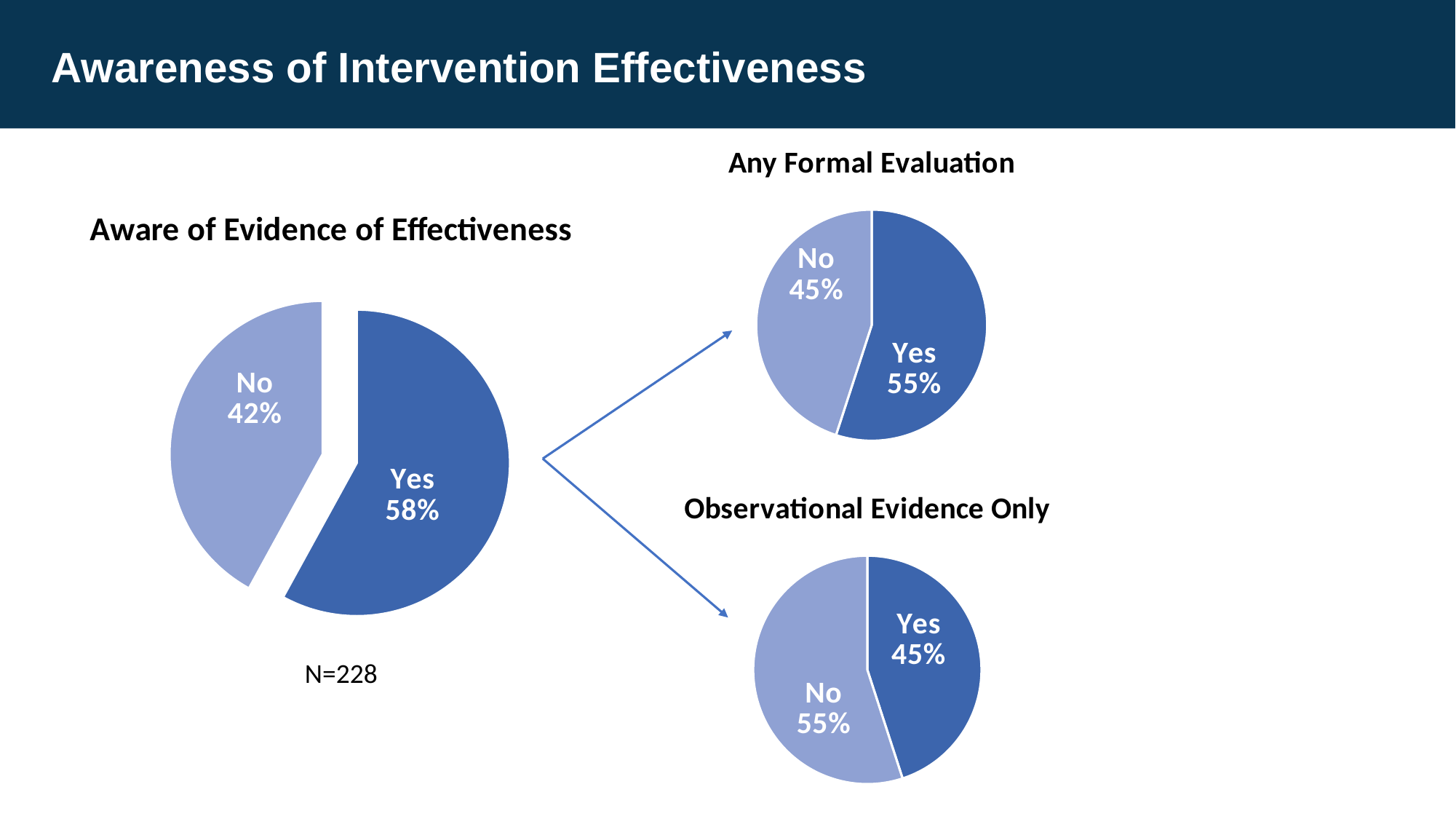
In the 'Aware of Evidence of Effectiveness' chart, what percentage answered No? 42% In the 'Aware of Evidence of Effectiveness' chart, what percentage answered Yes? 58% How many slices does the 'Observational Evidence Only' chart have? 2 In the 'Aware of Evidence of Effectiveness' chart, which slice is larger, Yes or No? Yes In the 'Any Formal Evaluation' chart, what is the share for Yes? 55% In the 'Aware of Evidence of Effectiveness' chart, what is the difference in percentage points between Yes and No? 16 In the 'Any Formal Evaluation' chart, which slice is the smallest? No In the 'Observational Evidence Only' chart, which slice is the largest? No In the 'Observational Evidence Only' chart, what is the share for No? 55% In the 'Observational Evidence Only' chart, what is the share for Yes? 45% What type of chart is used for 'Any Formal Evaluation'? Pie chart